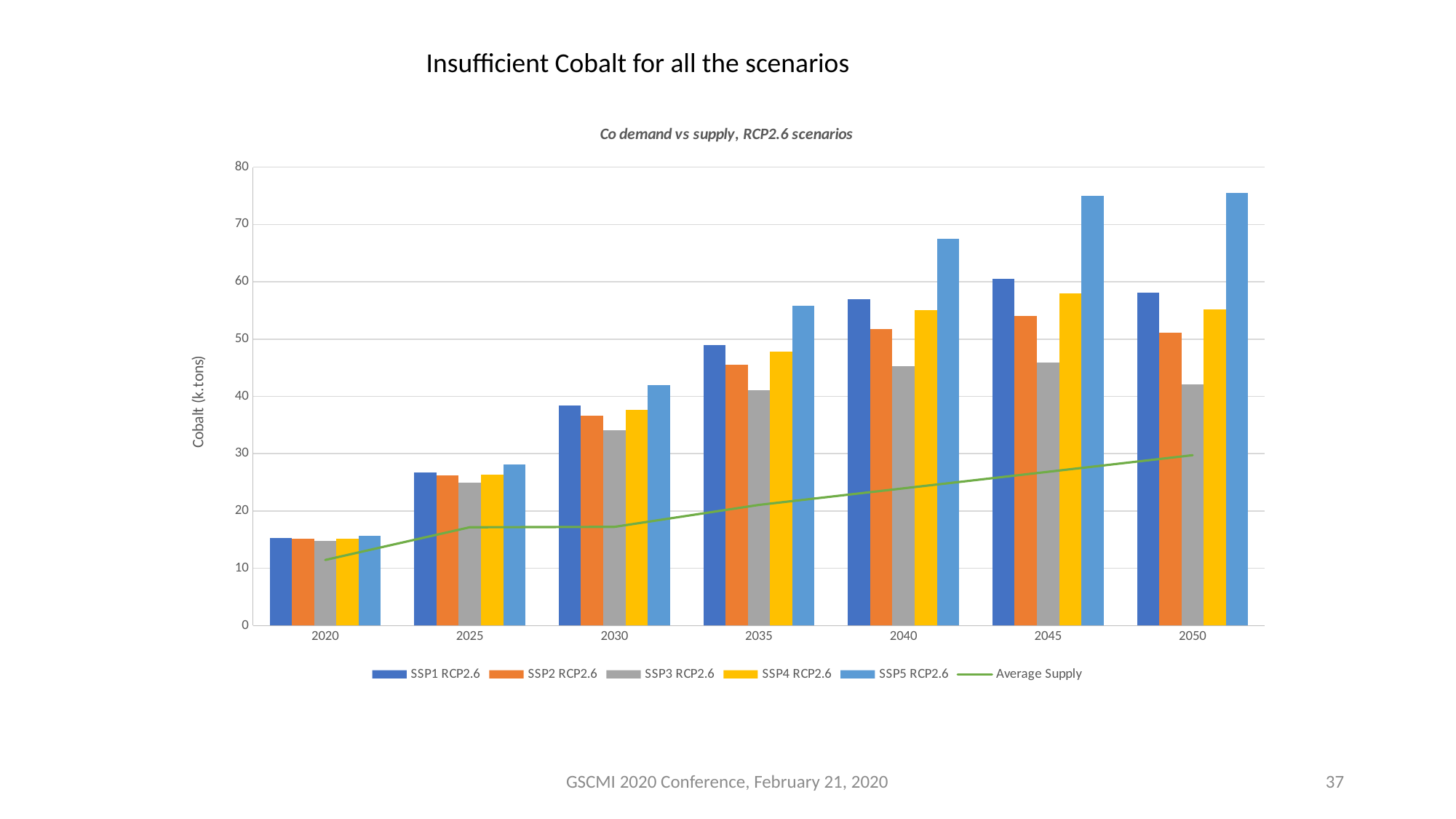
In 2040, which is larger: SSP1 RCP2.6 or SSP2 RCP2.6? SSP1 RCP2.6 What kind of chart is shown on the slide? bar chart (with a line series for Average Supply) How many years are shown on the x axis? 7 Is the value for SSP5 RCP2.6 in 2045 greater or less than 70? greater Which series has the highest value in 2050? SSP5 RCP2.6 Is the Average Supply value in 2040 greater or less than 30? less Does the Average Supply line rise or fall from 2020 to 2050? rises What is the label on the y axis? Cobalt (k.tons) Is the value for SSP5 RCP2.6 in 2040 greater or less than 60? greater Which bar series has the lowest value in 2045? SSP3 RCP2.6 How many series does the legend list? 6